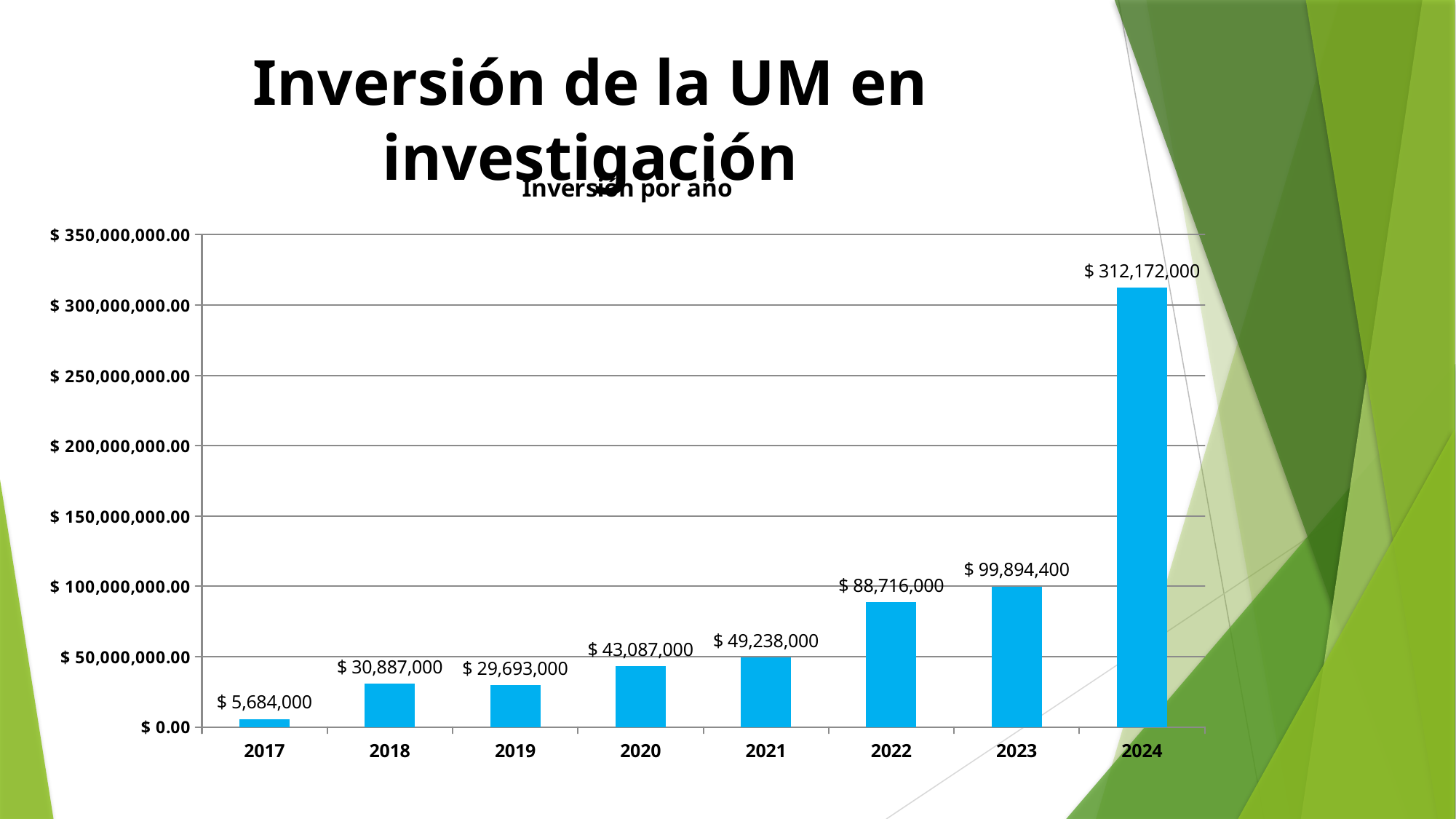
Which year has the lowest investment? 2017 What is the investment value shown for 2024? $ 312,172,000 What is the difference between the investment in 2018 and in 2019? $ 1,194,000 What is the investment value shown for 2021? $ 49,238,000 What is the title of the chart? Inversión por año Which year has the highest investment? 2024 What kind of chart is shown on the slide? Bar chart Is the value for 2023 greater or less than $ 50,000,000.00? greater What is the difference between the investment in 2024 and in 2023? $ 212,277,600 Which year has a larger investment, 2022 or 2021? 2022 What is the investment value shown for 2017? $ 5,684,000 How many years are shown on the x axis? 8